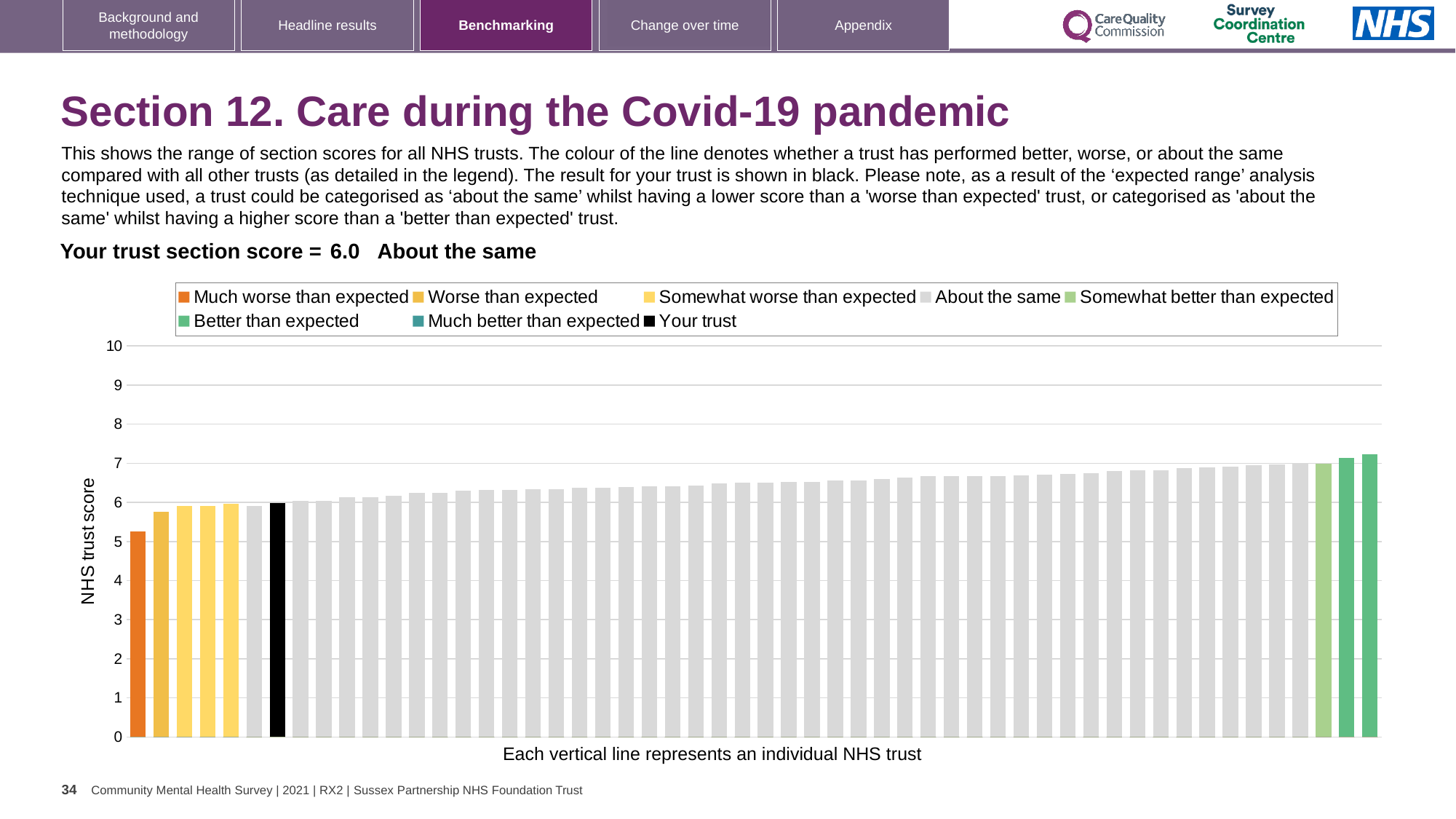
Is the value of the leftmost (orange) bar greater or less than 6? less What colour is the bar representing your trust? black What kind of chart is shown on the slide? bar chart How many entries does the chart legend list? 8 What is the section score for your trust shown on the slide? 6.0 Is the value of the rightmost bar greater or less than 7? greater Is the value for your trust (the black bar) greater or less than 5? greater Do the bar values rise or fall from left to right along the x axis? rise What is the label on the vertical axis of the chart? NHS trust score Which is higher: the orange 'Much worse than expected' bar or the black 'Your trust' bar? the black 'Your trust' bar How many bars are coloured orange (Much worse than expected)? 1 Which category is your trust placed in according to the text above the chart? About the same